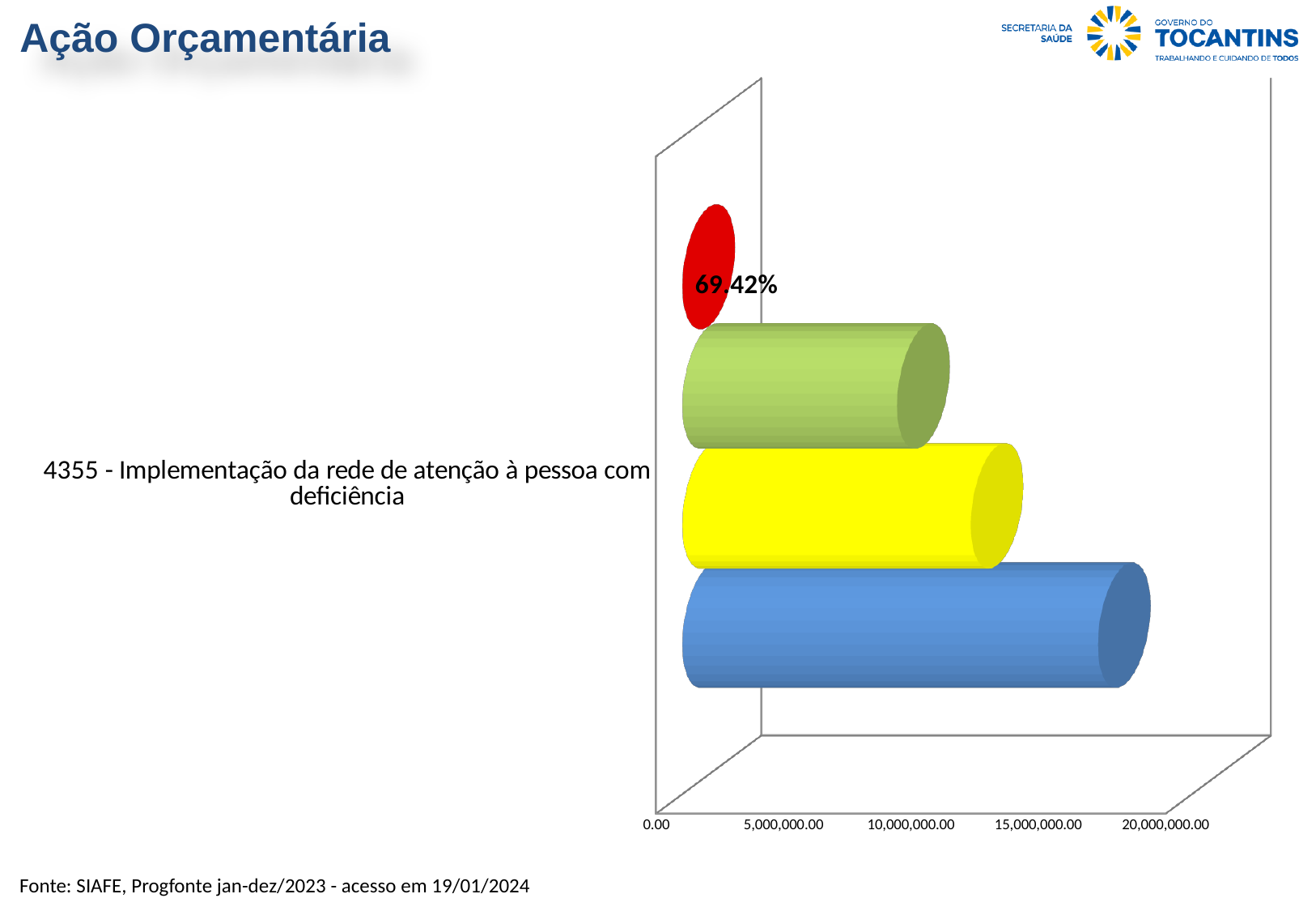
Which coloured bar is the shortest in the chart? red How many categories does the chart show on its category axis? 1 What data label is printed on the red bar? 69.42% What kind of chart is shown on the slide? bar chart Which is larger, the blue bar or the yellow bar? blue How many bars are plotted in the chart? 4 Which is larger, the yellow bar or the green bar? yellow Is the value of the blue bar greater or less than 15,000,000.00? greater Which coloured bar is the longest in the chart? blue What is the category label shown on the chart's vertical axis? 4355 - Implementação da rede de atenção à pessoa com deficiência Is the value of the red bar greater or less than 5,000,000.00? less Is the value of the yellow bar greater or less than 10,000,000.00? greater